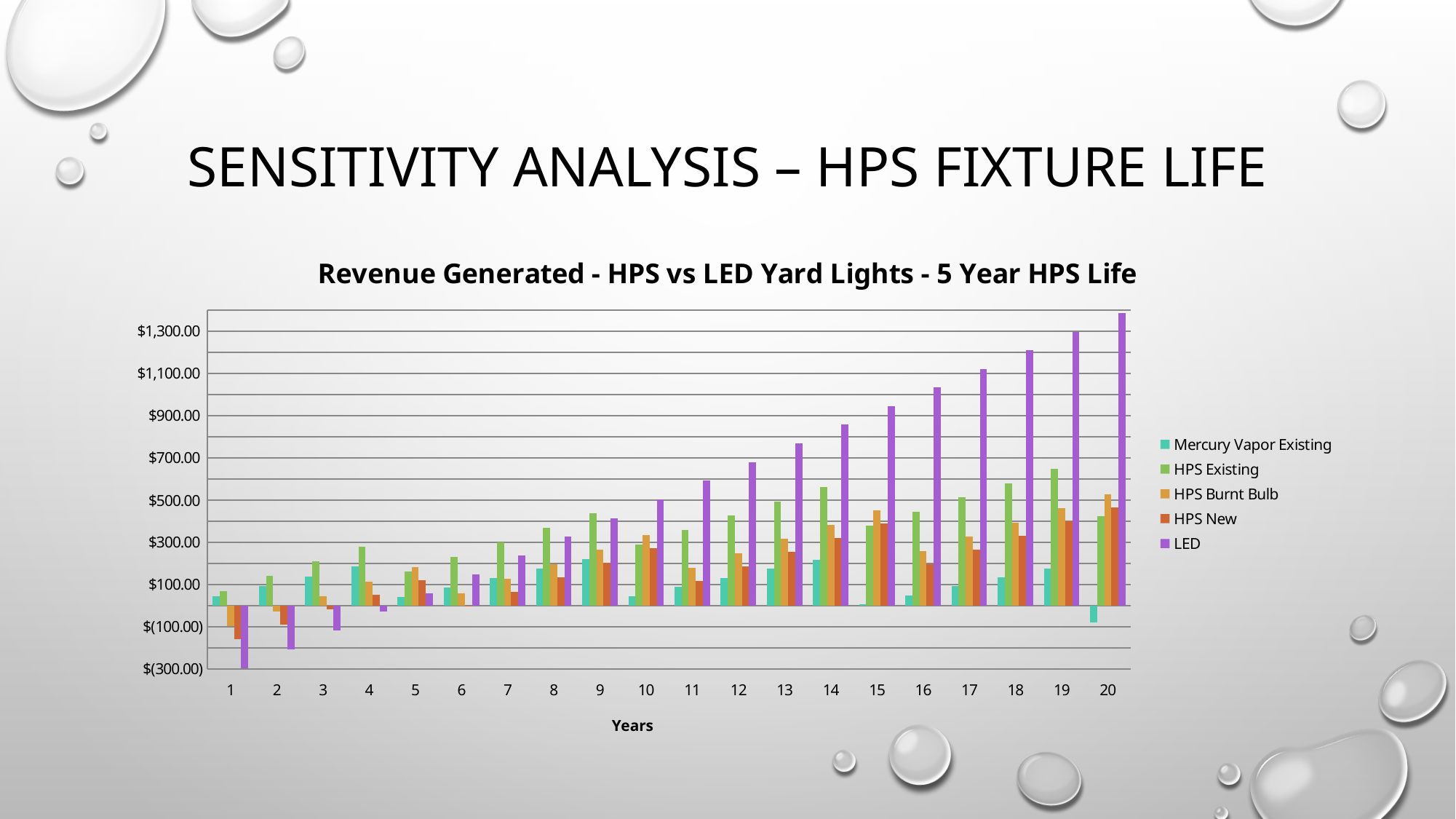
What kind of chart is shown on the slide? Bar chart Is the HPS Existing value in year 19 greater or less than $700.00? less What is the title of the chart? Revenue Generated - HPS vs LED Yard Lights - 5 Year HPS Life What is the label on the x axis? Years Which series has the lowest value in year 1? LED Is the LED value in year 1 greater or less than $(100.00)? less How many series does the legend list? 5 Which series has the highest value in year 20? LED How many years are shown along the x axis? 20 In year 1, which is larger: HPS Existing or LED? HPS Existing Is the LED value in year 20 greater or less than $1,300.00? greater Do the LED values generally rise or fall as the years increase? rise